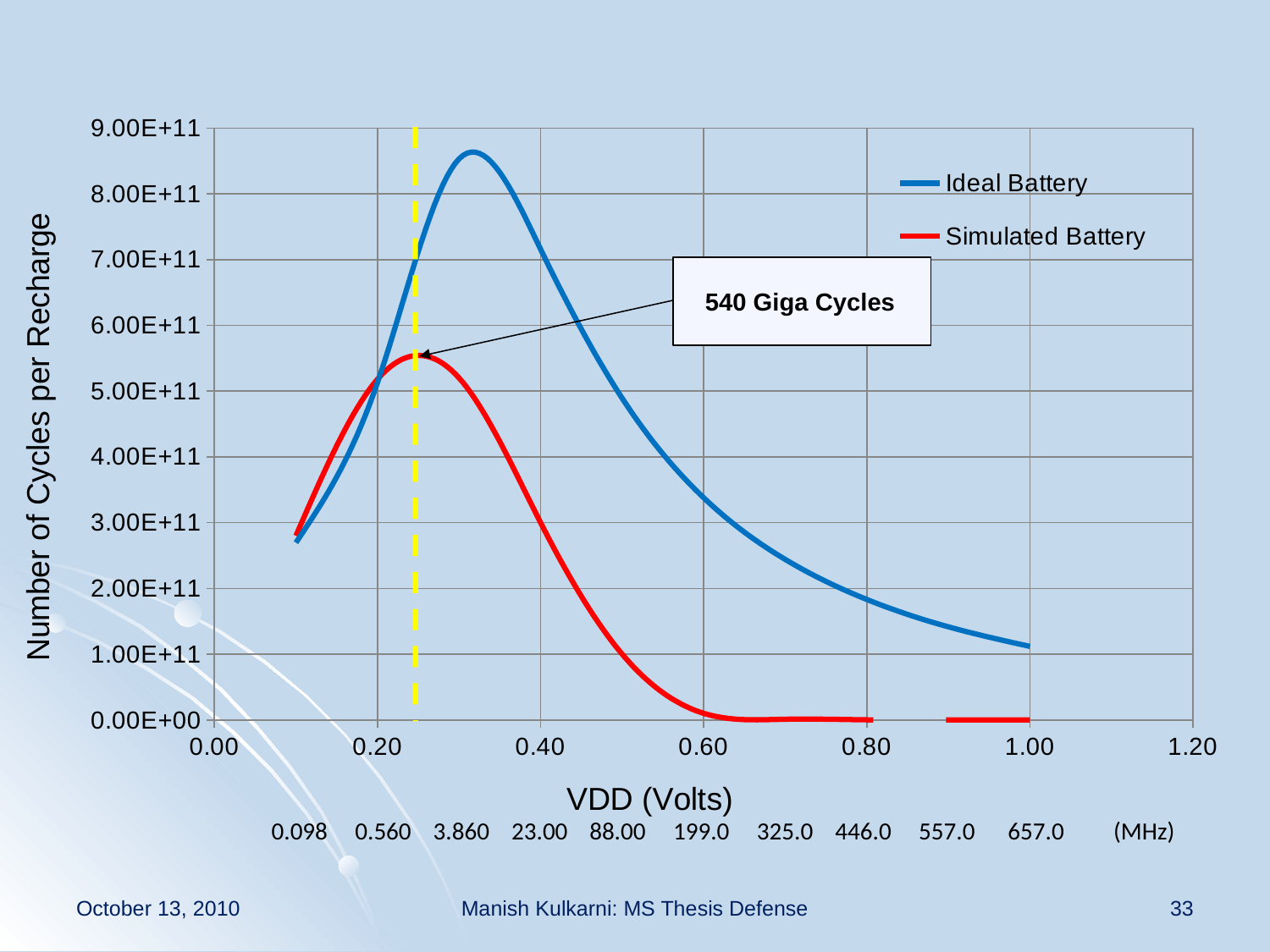
Is the peak value of the Ideal Battery curve greater or less than 8.00E+11? greater Which series reaches the higher peak value? Ideal Battery What kind of chart is shown on the slide? line chart How many series does the legend list? 2 What are the two series named in the legend? Ideal Battery and Simulated Battery Does the Ideal Battery curve rise or fall as VDD increases from 0.40 to 1.00? fall Is the Simulated Battery value at VDD 0.80 greater or less than 1.00E+11? less Is the Ideal Battery value at VDD 1.00 greater or less than 2.00E+11? less At VDD 0.60, which series has the higher number of cycles per recharge? Ideal Battery What is the label of the y axis? Number of Cycles per Recharge What value does the annotation give for the peak of the Simulated Battery curve? 540 Giga Cycles Does the Simulated Battery curve rise or fall as VDD increases from 0.10 to 0.20? rise